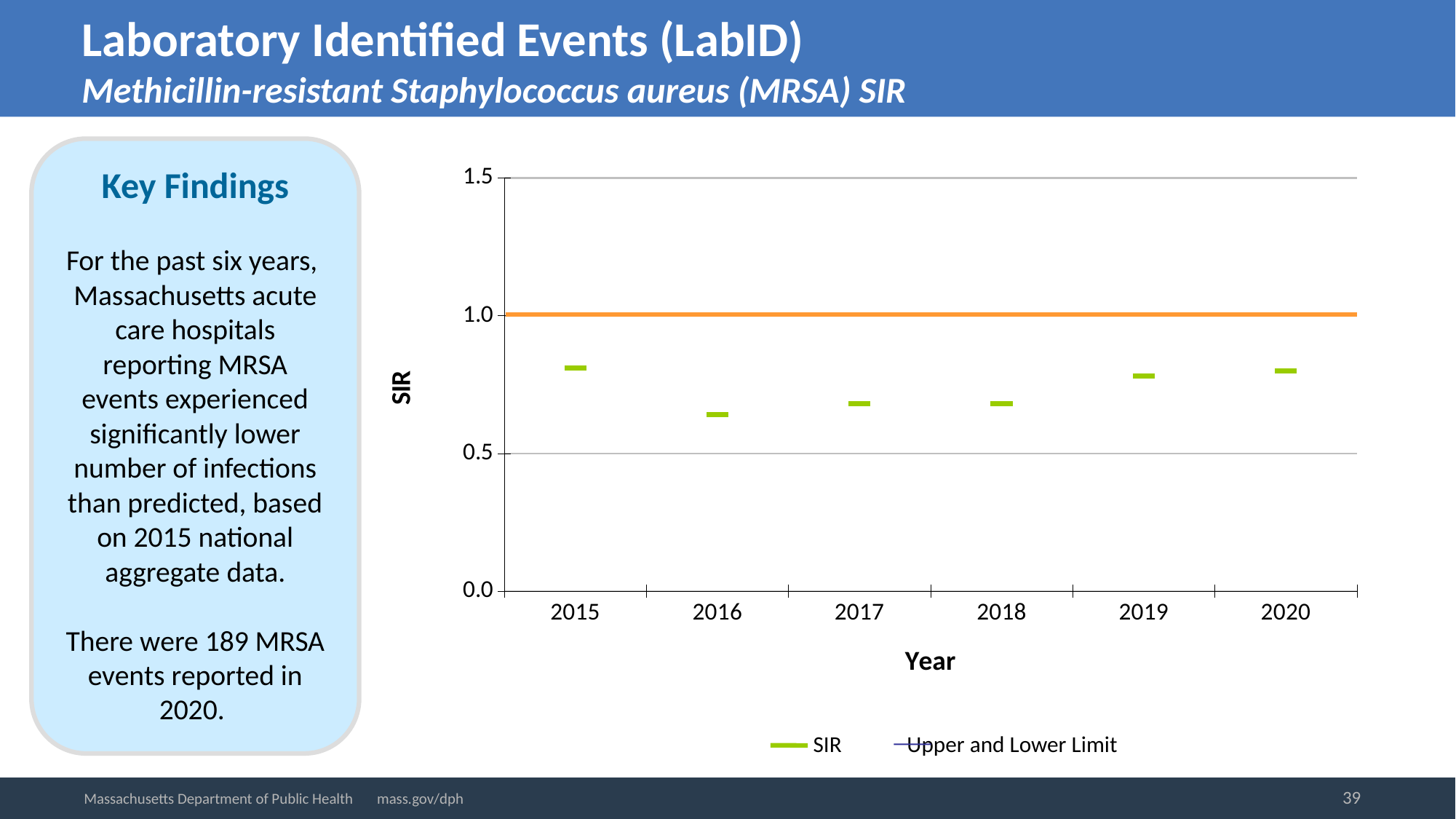
Which year has the larger SIR value, 2019 or 2017? 2019 Does the SIR value rise or fall from 2015 to 2016? fall How many years are shown on the x axis of the chart? 6 Is the SIR value for 2020 greater or less than 1.0? less What is the label of the y axis of the chart? SIR What is the second entry listed in the chart legend? Upper and Lower Limit Which year has the lowest SIR value in the chart? 2016 Is the SIR value for 2016 greater or less than 0.5? greater Is the SIR value for 2015 greater or less than 1.0? less Does the SIR value rise or fall from 2016 to 2020? rise Which year has the larger SIR value, 2015 or 2016? 2015 How many series does the chart legend list? 2